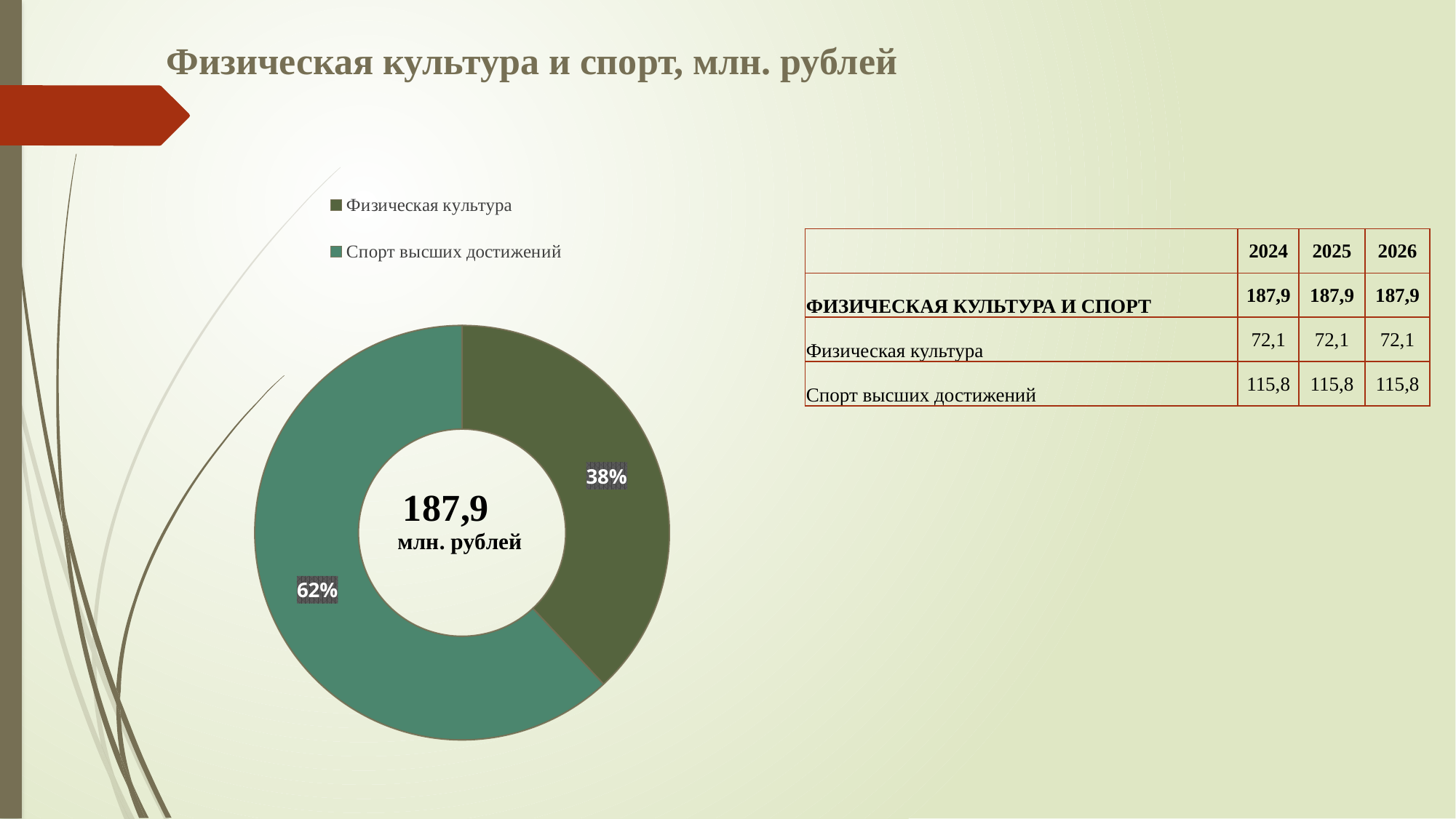
Which legend entry is shown in the lighter teal-green colour? Спорт высших достижений How many slices does the doughnut chart have? 2 Which slice is larger: Физическая культура or Спорт высших достижений? Спорт высших достижений Is the share for Спорт высших достижений greater or less than 50%? greater What share of the doughnut chart does Физическая культура take? 38% Which category has the largest slice in the doughnut chart? Спорт высших достижений Which category has the smallest slice in the doughnut chart? Физическая культура What is the difference in percentage points between the Спорт высших достижений slice and the Физическая культура slice? 24 percentage points What share of the doughnut chart does Спорт высших достижений take? 62% How many entries does the chart legend list? 2 What kind of chart is shown on the slide? Doughnut (pie) chart What total value is printed in the centre of the doughnut chart? 187,9 млн. рублей